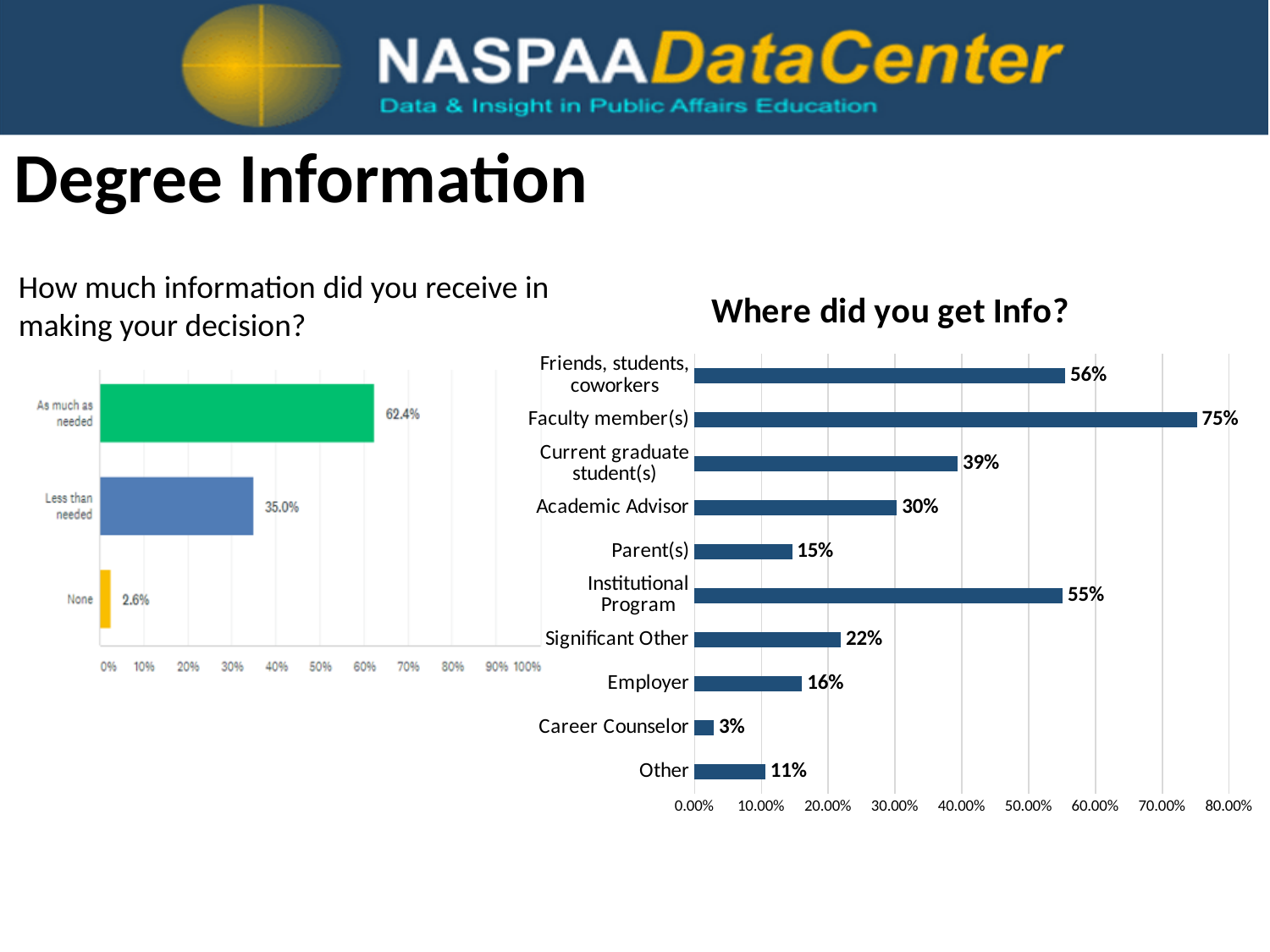
How many categories are shown in the 'Where did you get Info?' chart? 10 In the chart on the left ('How much information did you receive in making your decision?'), what is the difference between 'As much as needed' and 'Less than needed'? 27.4% In the 'Where did you get Info?' chart, which category has the lowest value? Career Counselor In the 'Where did you get Info?' chart, what is the value for Faculty member(s)? 75% What kind of chart is the 'Where did you get Info?' chart? Bar chart In the chart on the left ('How much information did you receive in making your decision?'), what is the value for 'None'? 2.6% In the 'Where did you get Info?' chart, which is larger: Institutional Program or Current graduate student(s)? Institutional Program In the chart on the left ('How much information did you receive in making your decision?'), what is the value for 'As much as needed'? 62.4% How many categories are shown in the chart on the left ('How much information did you receive in making your decision?')? 3 In the 'Where did you get Info?' chart, what is the difference between Faculty member(s) and Academic Advisor? 45% In the 'Where did you get Info?' chart, which category has the highest value? Faculty member(s) In the 'Where did you get Info?' chart, what is the value for Career Counselor? 3%